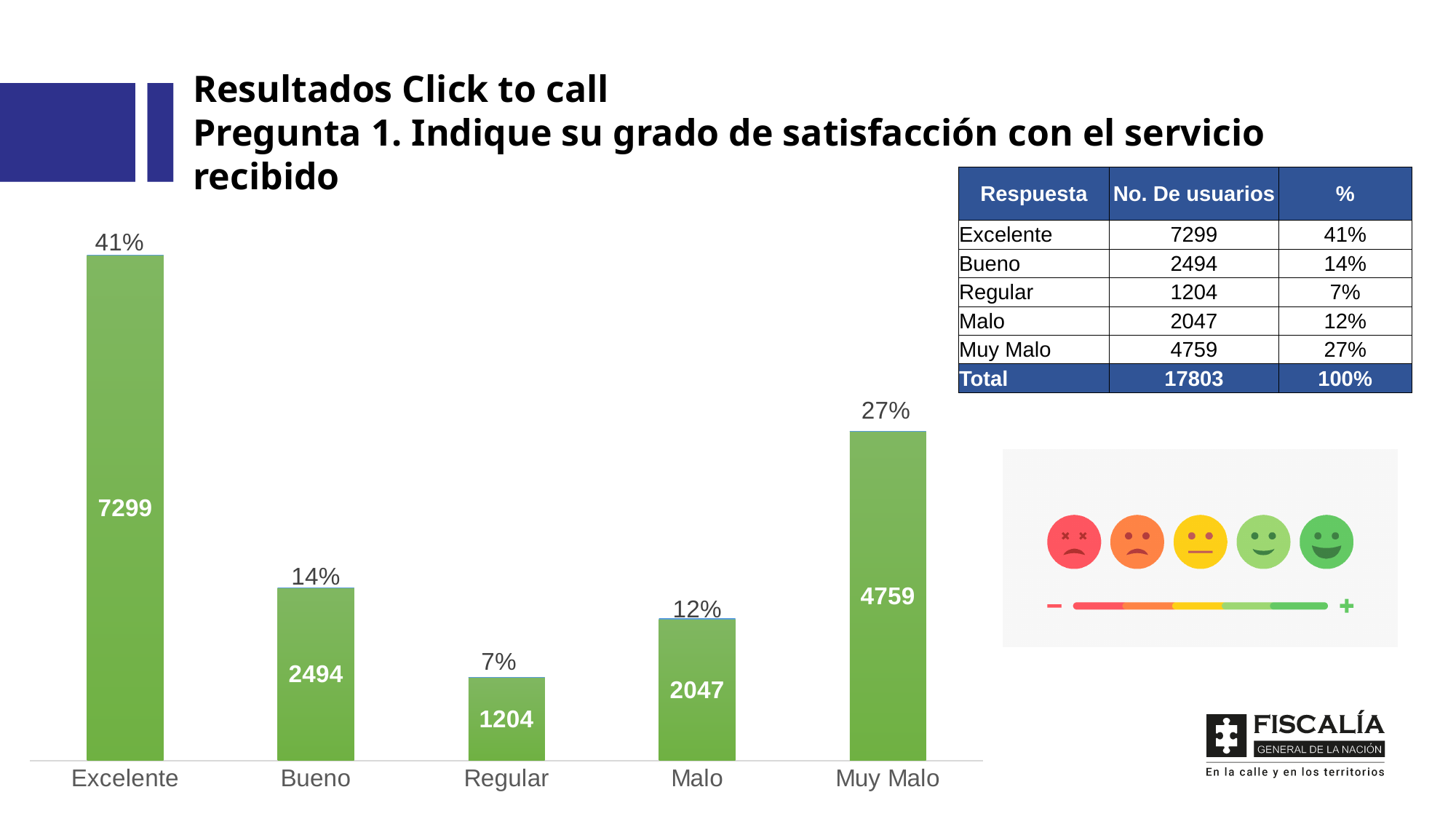
What is the difference between the values for Excelente and Muy Malo? 2540 What percentage is shown above the Bueno bar? 14% How many categories does the bar chart show? 5 Which is larger, the value for Bueno or the value for Malo? Bueno What kind of chart is shown on the slide? bar chart What is the difference in percentage points between Malo and Regular? 5 What is the value for Regular in the bar chart? 1204 What is the total number of users shown in the table? 17803 What is the number of users for Excelente in the bar chart? 7299 What percentage is shown above the Muy Malo bar? 27% Which category has the lowest bar? Regular Which category has the highest bar? Excelente